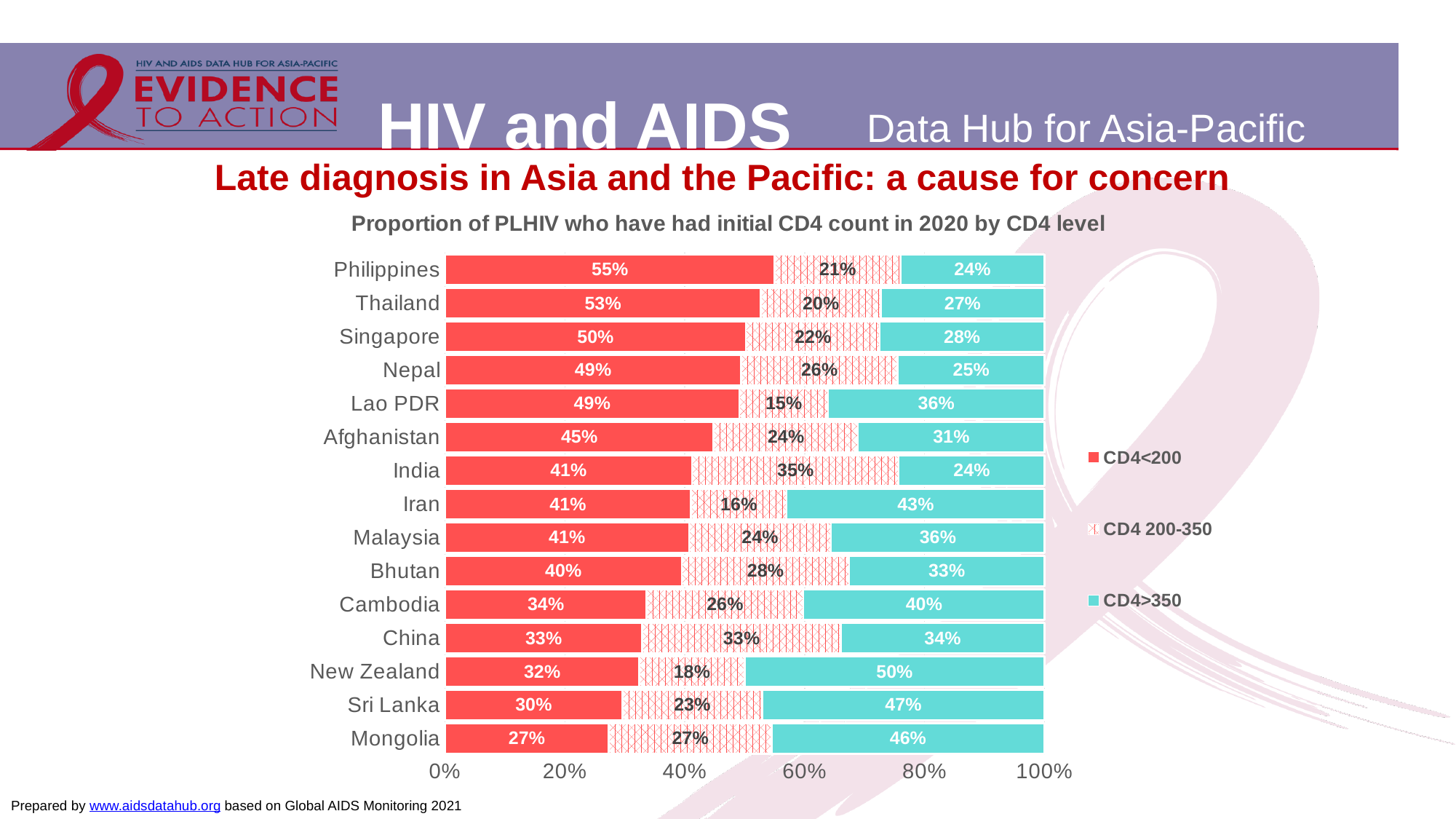
Which country has the lowest CD4<200 proportion? Mongolia What is the difference between the CD4<200 values for Thailand and Mongolia? 26% How many countries are shown in the chart? 15 What is the CD4 200-350 value for India? 35% What is the CD4<200 value for the Philippines? 55% What is the total of the three segments for Cambodia? 100% What is the title of the chart? Proportion of PLHIV who have had initial CD4 count in 2020 by CD4 level What is the CD4>350 value for New Zealand? 50% How many series does the legend list? 3 Which country has the highest CD4<200 proportion? Philippines What kind of chart is shown on the slide? Stacked bar chart Which is larger, the CD4>350 value for Iran or for Lao PDR? Iran